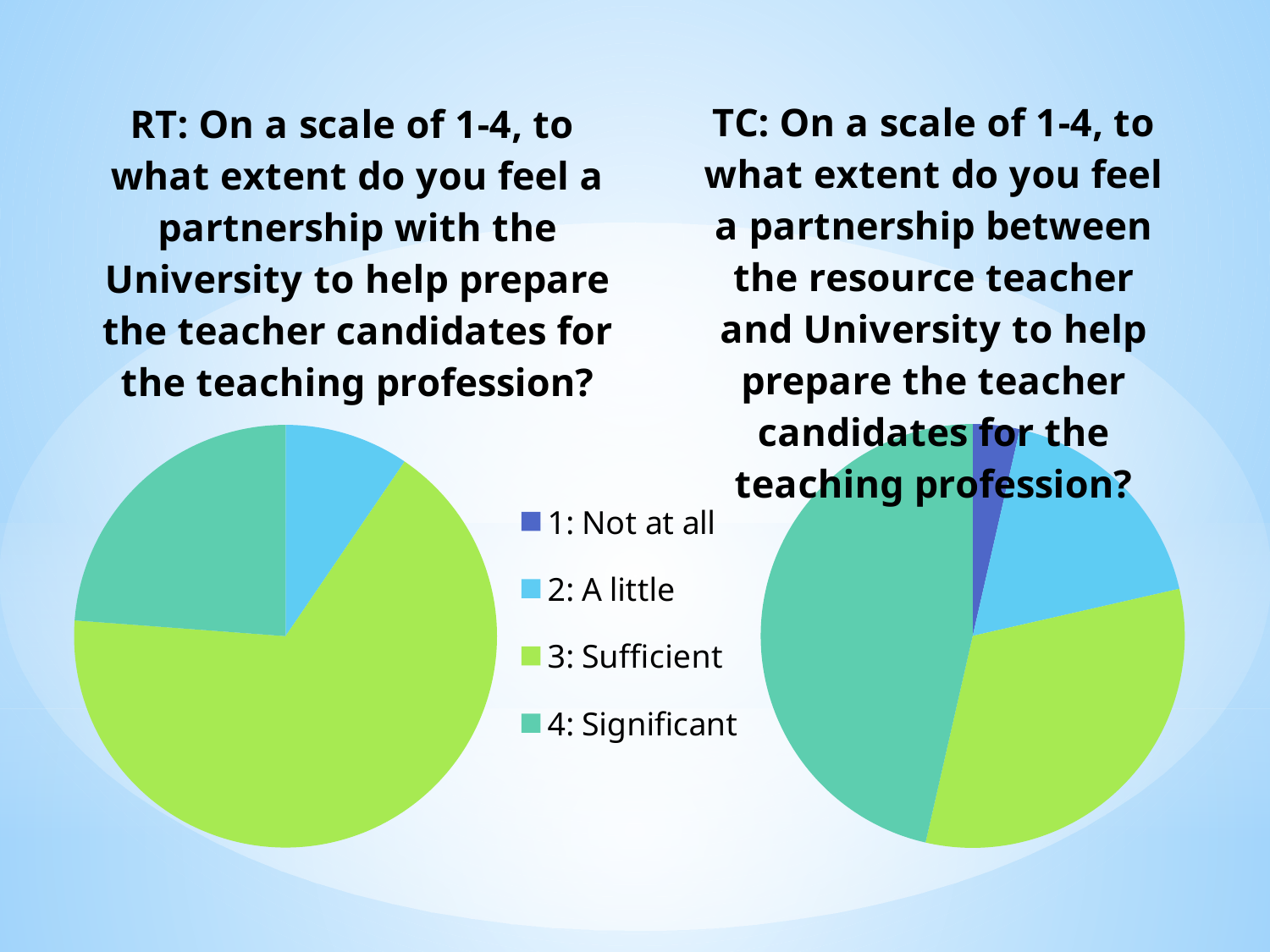
In the right chart (TC), which category has the largest slice? 4: Significant How many categories does the legend list? 4 In the left chart (RT), which category has the largest slice? 3: Sufficient What kind of chart is the left chart (RT)? pie chart What kind of chart is the right chart (TC)? pie chart In the right chart (TC), which slice is larger: 3: Sufficient or 2: A little? 3: Sufficient In the left chart (RT), which visible category has the smallest slice? 2: A little In the right chart (TC), which category has the smallest slice? 1: Not at all How many slices are visible in the right chart (TC)? 4 Which legend entry is shown in dark blue? 1: Not at all In the left chart (RT), which slice is larger: 4: Significant or 2: A little? 4: Significant How many slices are visible in the left chart (RT)? 3